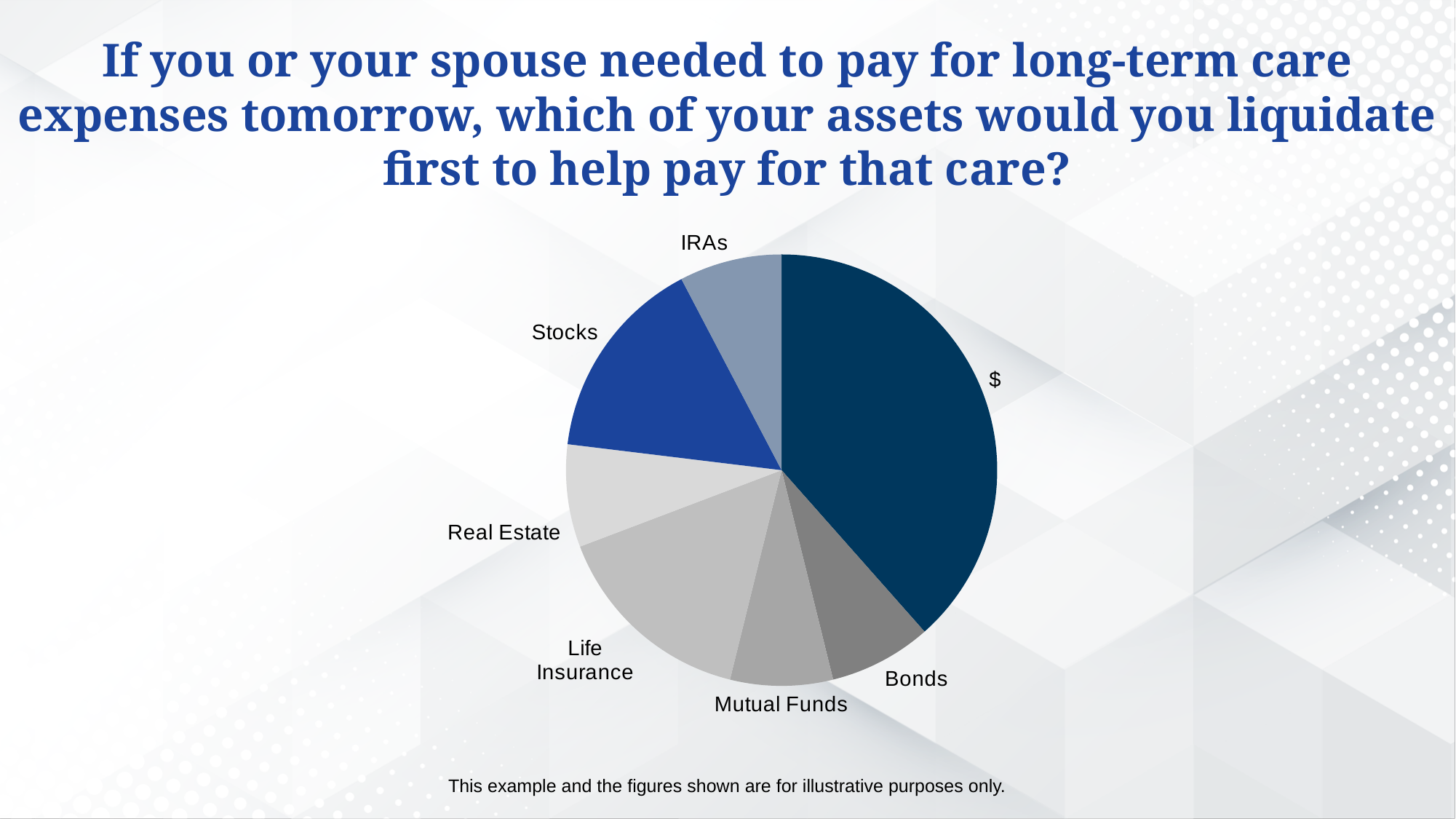
Which slice of the pie chart is the largest? $ Which slice is larger, Life Insurance or IRAs? Life Insurance Which slice is larger, $ or Stocks? $ Which slice is larger, Life Insurance or Bonds? Life Insurance What kind of chart is shown on the slide? Pie chart What does the note at the bottom of the slide say? This example and the figures shown are for illustrative purposes only. Which slice is labelled with a dollar sign? The largest slice How many slices does the pie chart have? 7